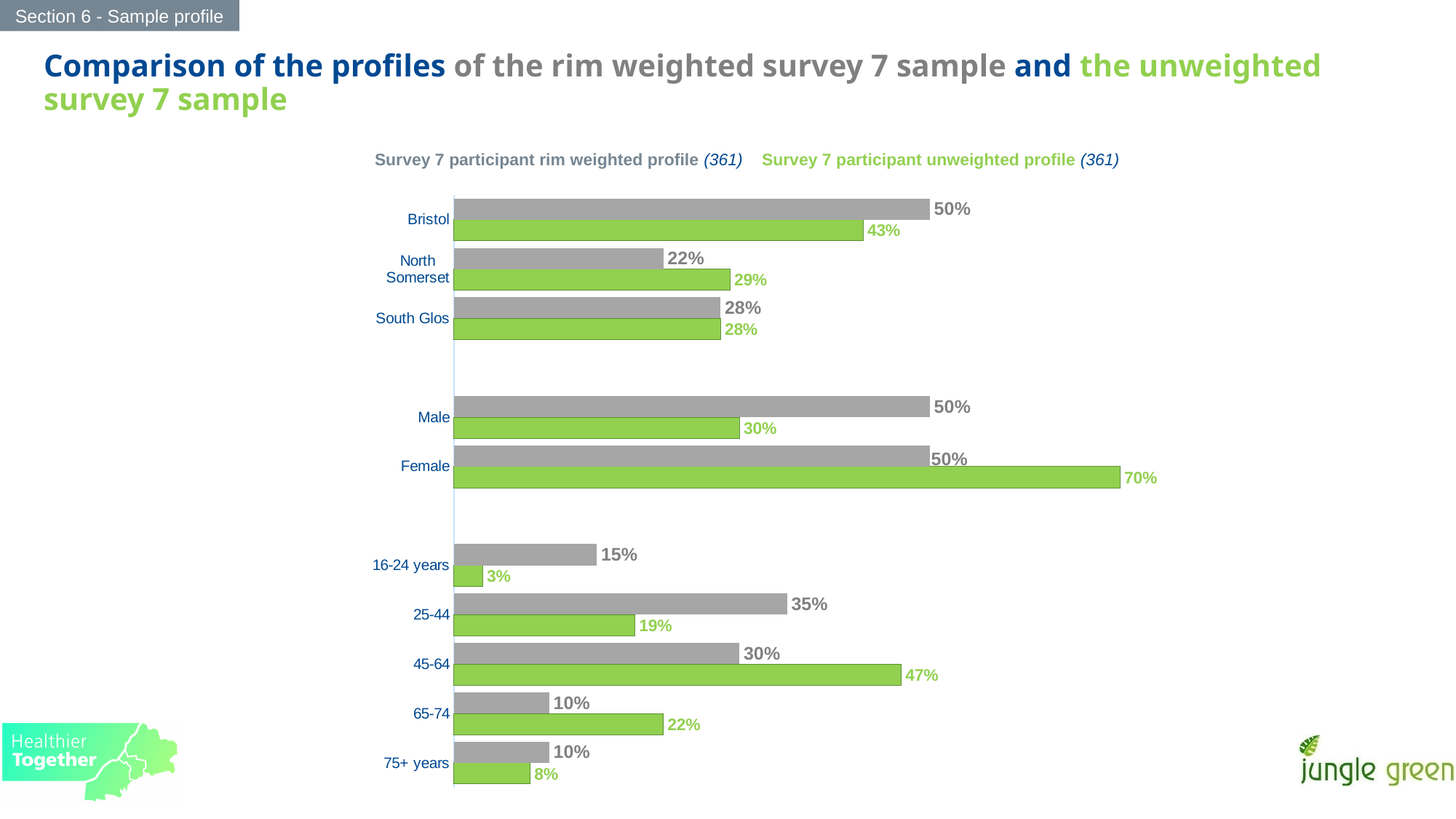
What is the rim weighted profile value for Bristol? 50% What is the rim weighted profile value for 25-44? 35% Which category has the highest unweighted profile value? Female What is the difference between the rim weighted and unweighted values for Male? 20% What is the unweighted profile value for Female? 70% Which is larger for North Somerset: the rim weighted value or the unweighted value? the unweighted value How many series does the chart show? 2 Which category has the lowest unweighted profile value? 16-24 years What is the difference between the unweighted and rim weighted values for 45-64? 17% What is the unweighted profile value for 16-24 years? 3% What kind of chart is shown on the slide? bar chart What colour are the bars for the Survey 7 participant unweighted profile? green